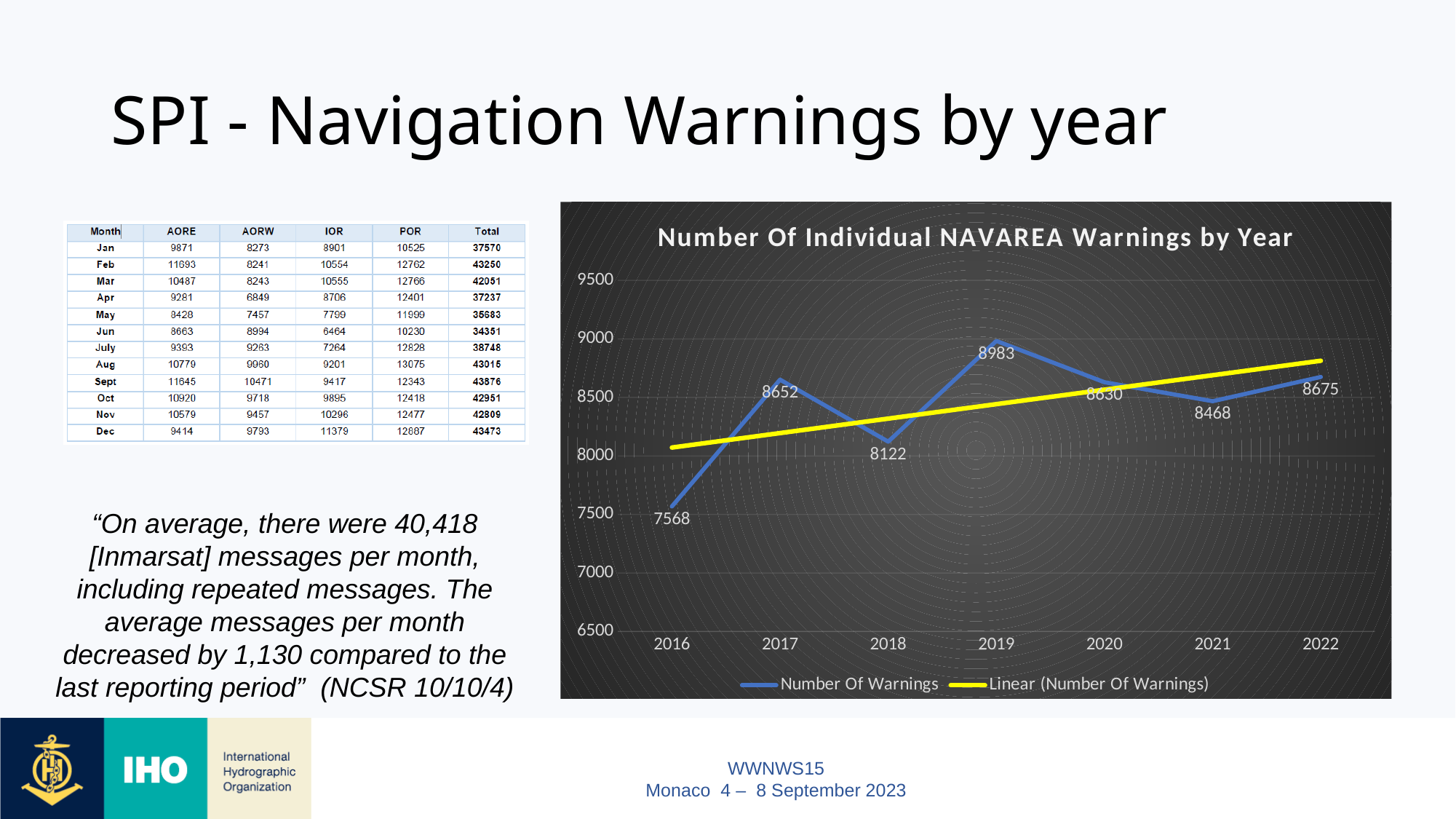
Is the value for 2020 greater or less than 8000? greater What is the number of warnings for 2019? 8983 What is the number of warnings for 2016? 7568 What is the number of warnings for 2018? 8122 What is the difference between the number of warnings in 2019 and in 2016? 1415 Which year had more warnings, 2017 or 2021? 2017 What is the number of warnings for 2022? 8675 What kind of chart is shown on the slide? line chart How many years are plotted on the chart? 7 Which year has the highest number of warnings? 2019 How many series does the legend list? 2 Which year has the lowest number of warnings? 2016